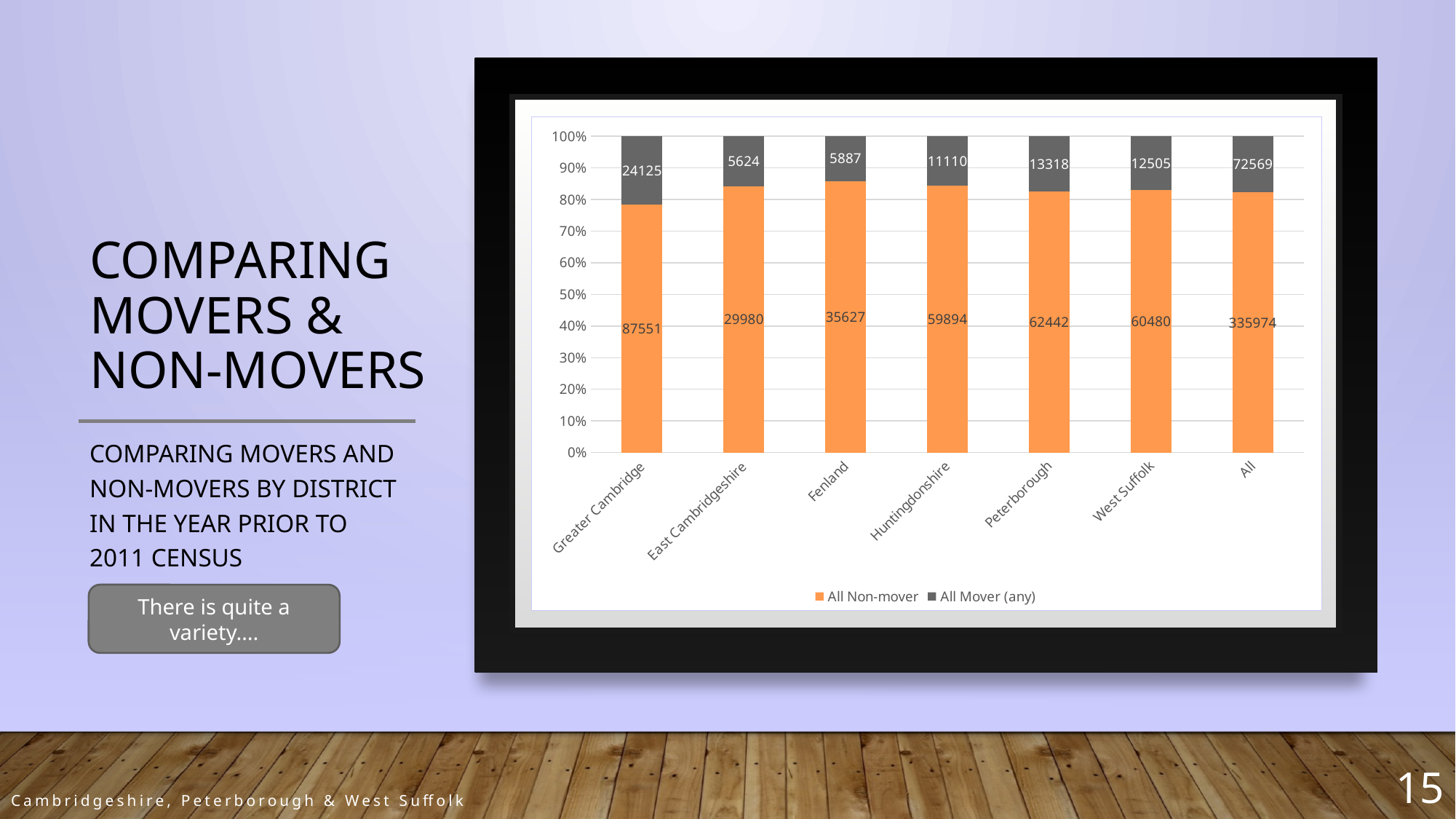
How many categories are shown on the x axis? 7 Among the individual districts (excluding All), which has the lowest All Non-mover value? East Cambridgeshire Is the All Non-mover share for Fenland greater or less than 80%? greater What is the difference between the All Non-mover values for Peterborough and West Suffolk? 1962 What is the value for All Mover (any) in Huntingdonshire? 11110 Among the individual districts (excluding All), which has the highest All Mover (any) value? Greater Cambridge What is the value for All Non-mover in the All category? 335974 What is the combined total of All Non-mover and All Mover (any) for East Cambridgeshire? 35604 Is the All Non-mover share for Greater Cambridge greater or less than 80%? less Which is larger, the All Mover (any) value for Peterborough or for West Suffolk? Peterborough What is the value for All Non-mover in Greater Cambridge? 87551 How many series does the legend list? 2